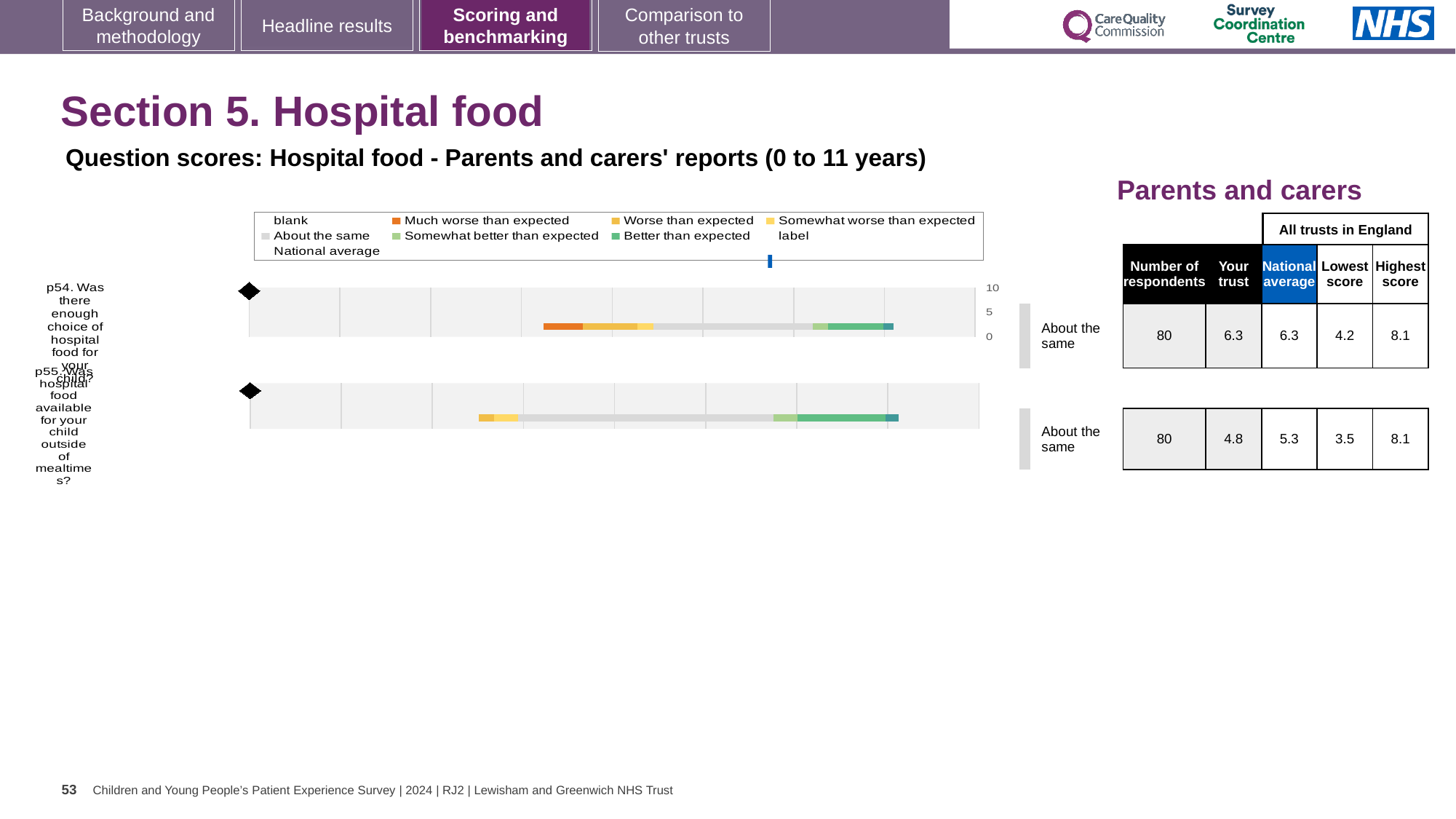
Which question has the higher 'Your trust' score, p54 or p55? p54 How is the trust's result for p55 categorised relative to expectations? About the same What is the difference between the 'Your trust' scores for p54 and p55? 1.5 How many respondents answered p54? 80 How many questions (categories) are plotted in the hospital food chart? 2 According to the table, what is the 'Your trust' score for p55 (hospital food available outside of mealtimes)? 4.8 What is the lowest score across all trusts in England for p54? 4.2 What is the national average score for p55 in the table? 5.3 Which colour does the legend use for 'Much worse than expected'? orange What is the maximum value shown on the chart's score axis? 10 According to the table, what is the 'Your trust' score for p54 (enough choice of hospital food)? 6.3 What kind of chart is used to show the question scores for hospital food? bar chart